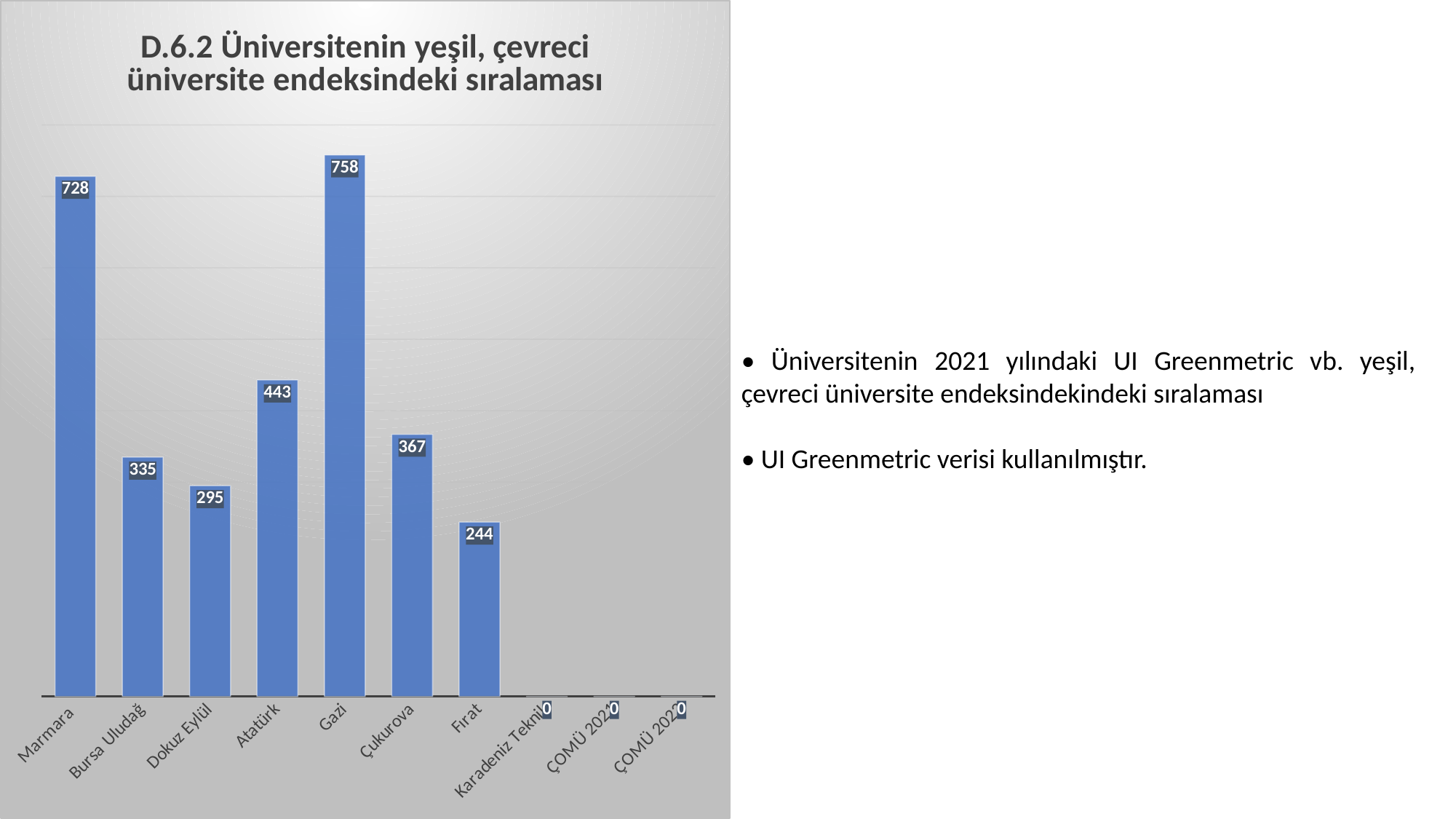
Which university has the highest value in the chart? Gazi What is the value shown for Marmara? 728 What is the difference between the values for Marmara and Bursa Uludağ? 393 How many categories are shown on the x axis of the chart? 10 Which has a larger value, Atatürk or Çukurova? Atatürk What is the value shown for Karadeniz Teknik? 0 What is the difference between the values for Gazi and Marmara? 30 What is the value shown for Fırat? 244 Which has a larger value, Dokuz Eylül or Bursa Uludağ? Bursa Uludağ What kind of chart is shown on the slide? Bar chart What is the value shown for Gazi? 758 What is the value shown for Atatürk? 443